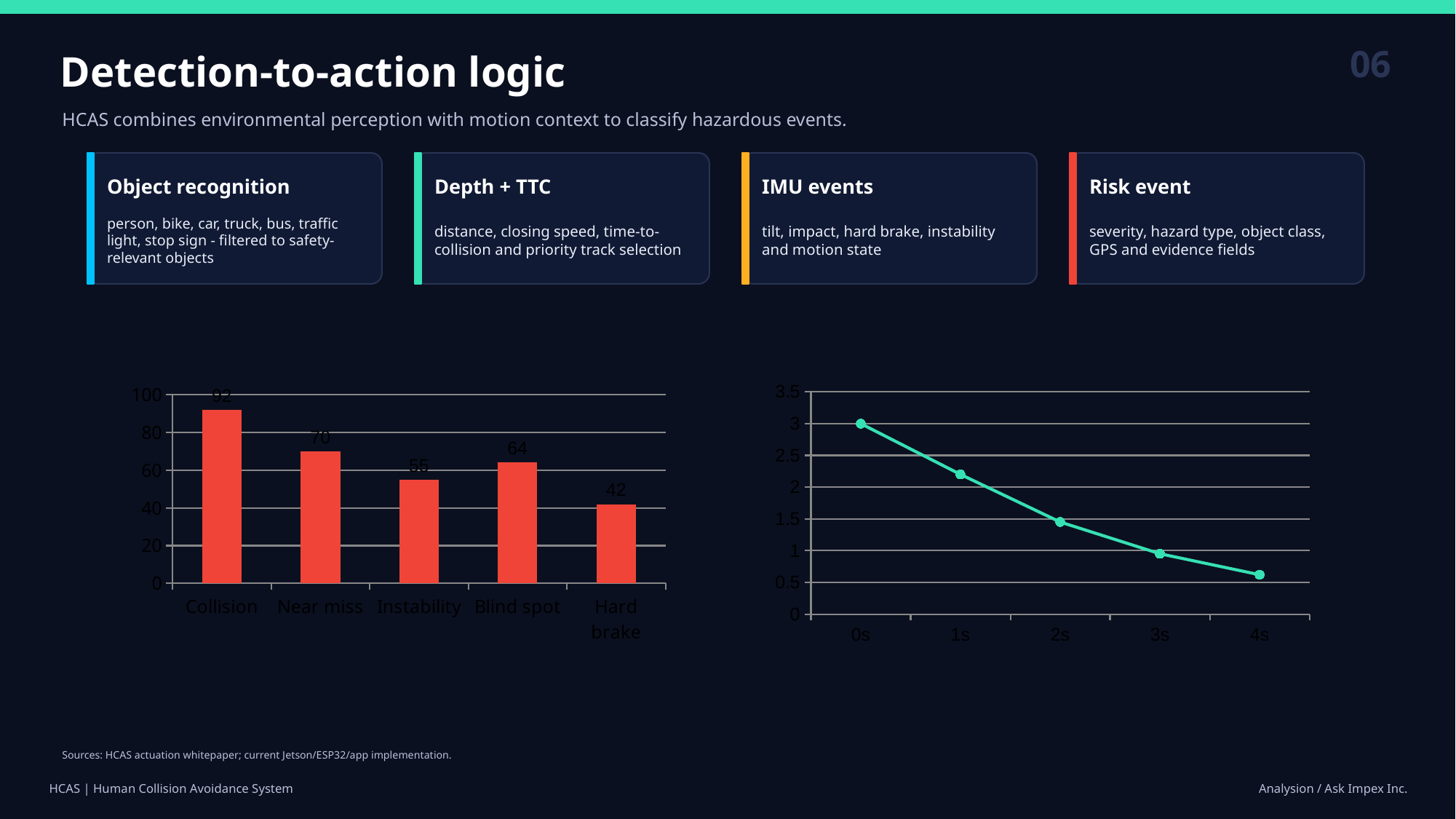
What kind of chart is the chart on the right of the slide? line chart In the bar chart on the left, which is larger, Blind spot or Instability? Blind spot In the line chart on the right, is the value at 1s greater or less than 2? greater In the bar chart on the left, which category has the highest value? Collision In the bar chart on the left, what is the value for Hard brake? 42 In the line chart on the right, do the values rise or fall from 0s to 4s? fall In the bar chart on the left, what is the value for Collision? 92 In the line chart on the right, is the value at 2s greater or less than 2? less In the bar chart on the left, which category has the lowest value? Hard brake How many categories are shown in the bar chart on the left? 5 In the bar chart on the left, what is the value for Blind spot? 64 In the bar chart on the left, what is the difference between the values for Near miss and Instability? 15